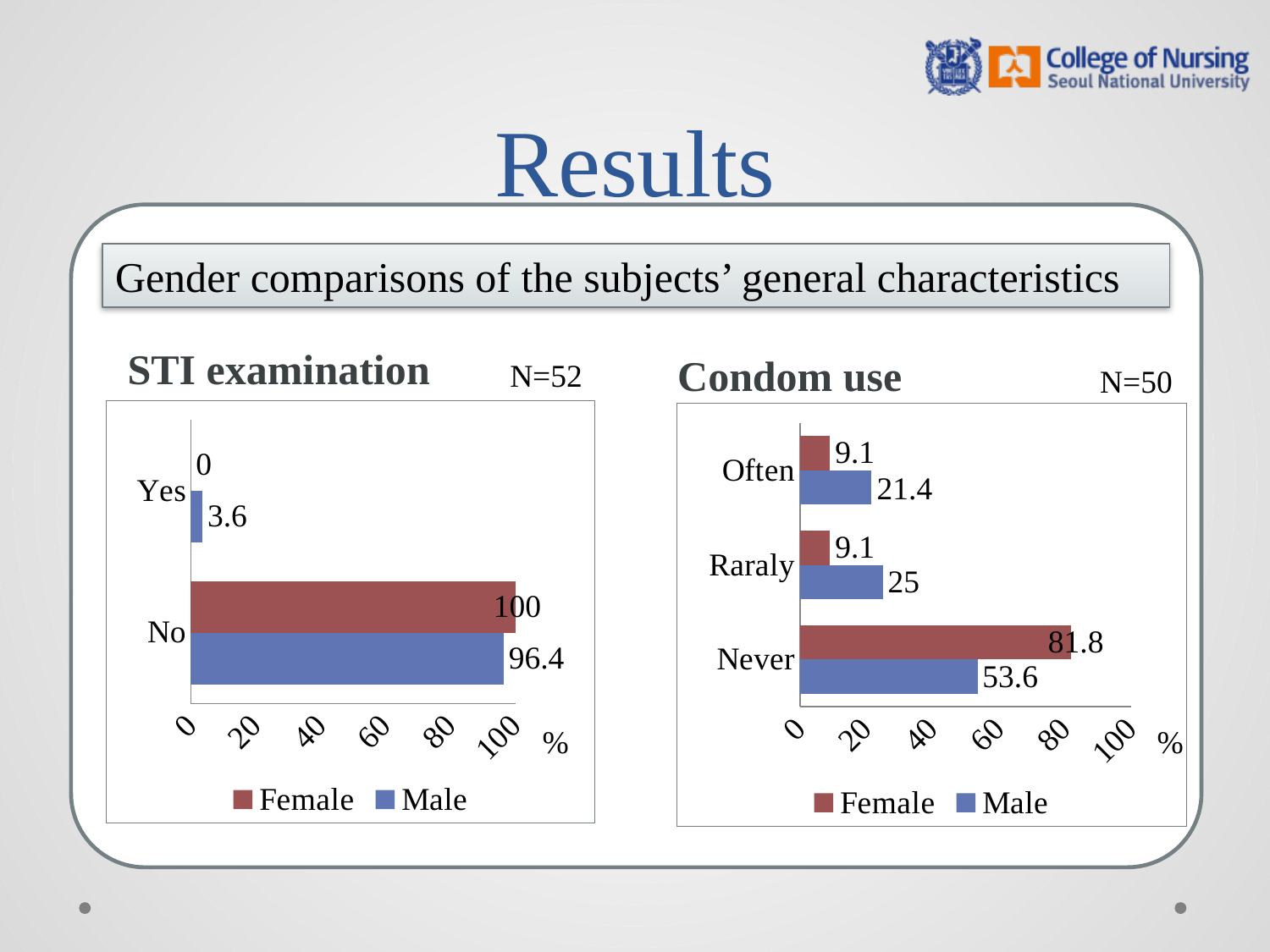
What kind of chart is the Condom use chart? Bar chart In the Condom use chart, which category has the lowest Male value? Often In the Condom use chart, what is the value for Female in the Often category? 9.1 How many categories does the Condom use chart show? 3 In the STI examination chart, what is the value for Female in the Yes category? 0 How many series does the legend of the STI examination chart list? 2 In the Condom use chart, which category has the highest Female value? Never In the STI examination chart, what is the value for Male in the No category? 96.4 In the Condom use chart, what is the difference between the Female and Male values for Never? 28.2 In the STI examination chart, what is the difference between the Female and Male values for No? 3.6 In the Condom use chart, what is the value for Male in the Never category? 53.6 In the Condom use chart, which is larger for Raraly: the Female value or the Male value? Male